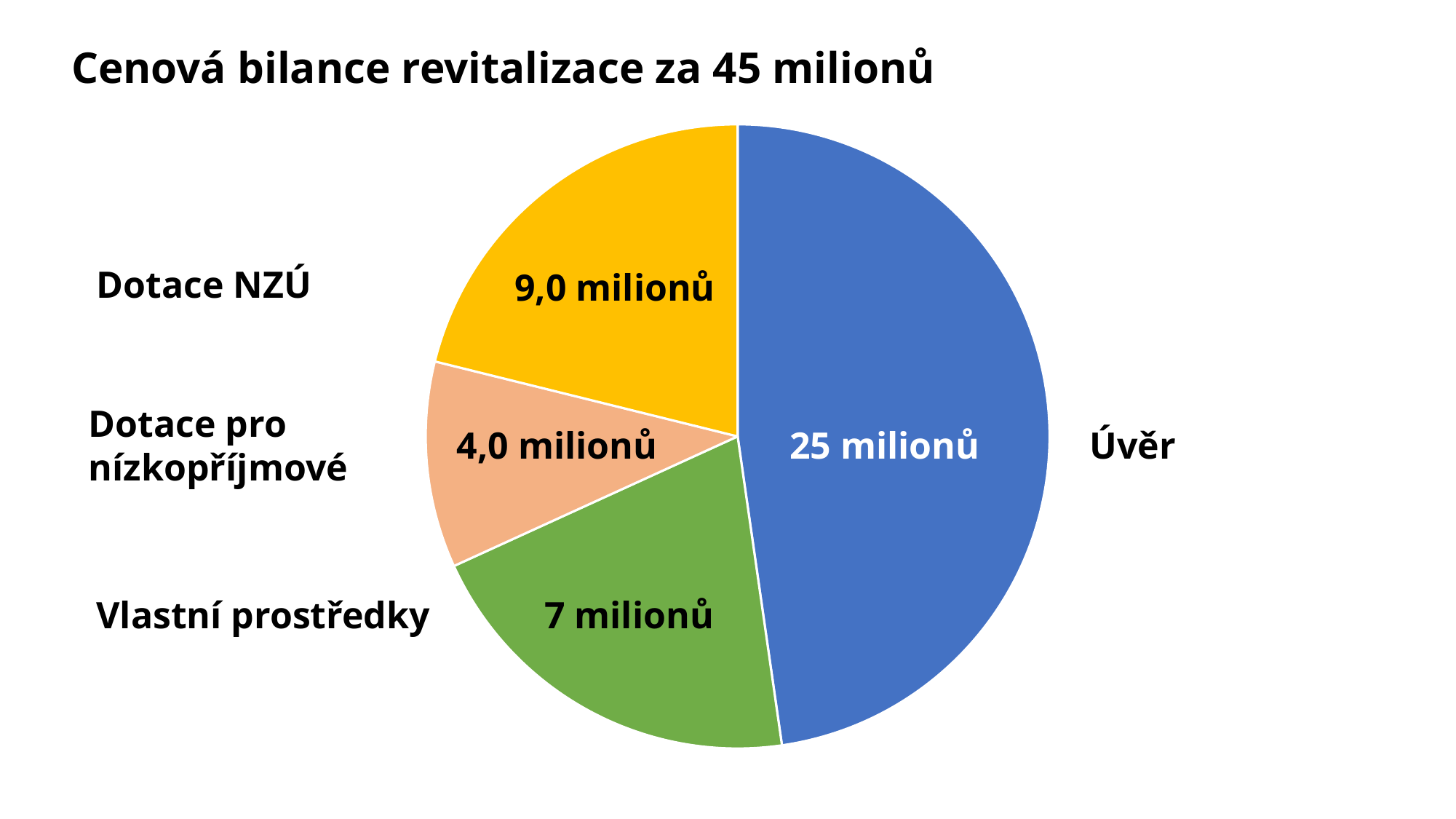
What is the value for Dotace NZÚ? 9,0 milionů Which is larger, Dotace NZÚ or Vlastní prostředky? Dotace NZÚ What is the difference between Úvěr and Dotace NZÚ? 16 milionů What is the value for Dotace pro nízkopříjmové? 4,0 milionů What is the value for Vlastní prostředky? 7 milionů What share of the total 45 milionů does Dotace NZÚ represent? 20% What is the value for Úvěr? 25 milionů How many slices does the pie chart have? 4 What kind of chart is shown on the slide? Pie chart What is the title of the chart? Cenová bilance revitalizace za 45 milionů Which category has the smallest slice? Dotace pro nízkopříjmové Which category has the largest slice? Úvěr